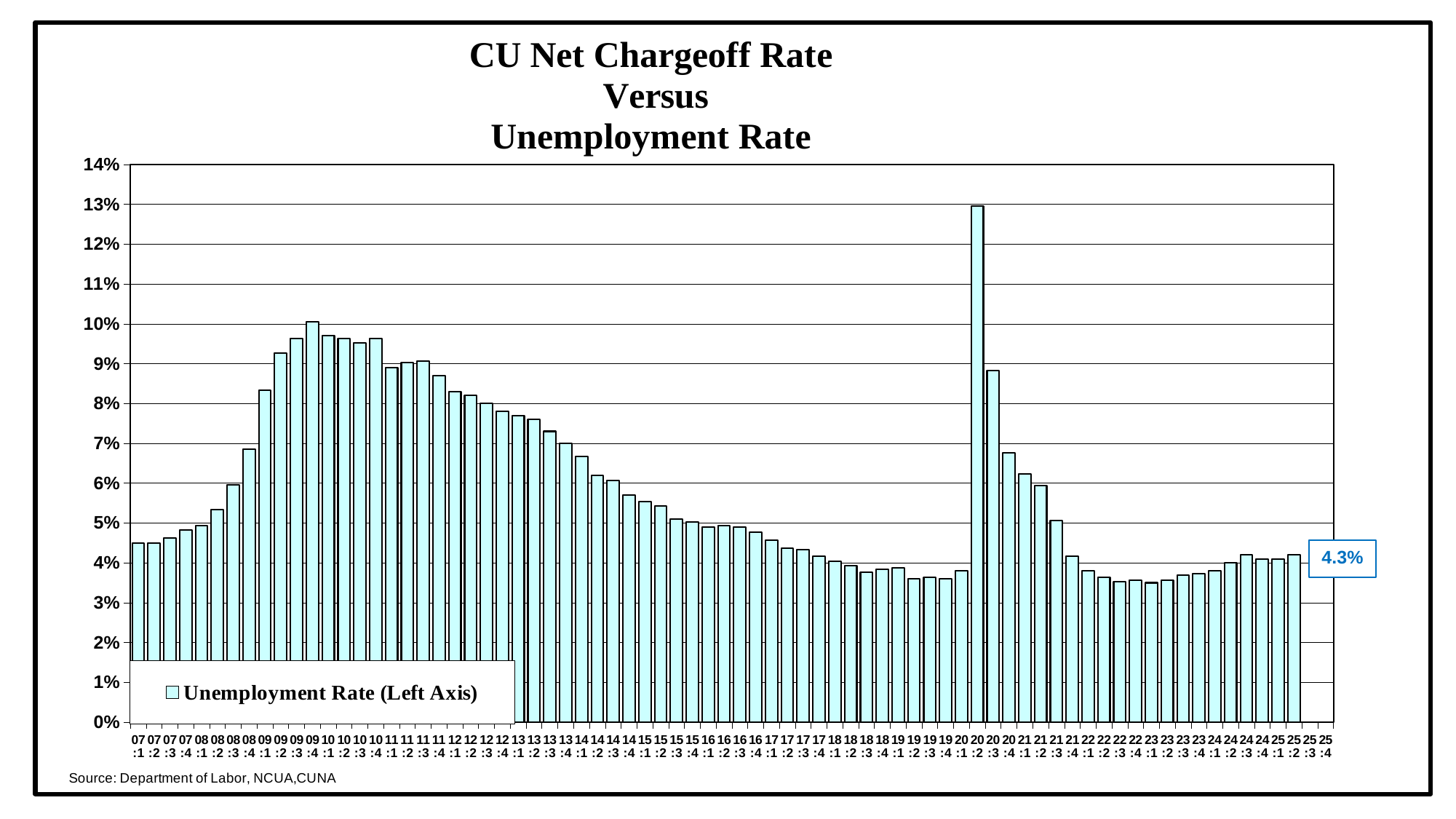
Which quarter has the higher unemployment rate, 20:2 or 09:4? 20:2 How many series does the legend list? 1 Is the unemployment rate for 13:1 greater or less than 7%? greater Do the unemployment rate values rise or fall from 09:4 to 19:4? fall Is the unemployment rate for 23:2 greater or less than 4%? less What is the title of the chart? CU Net Chargeoff Rate Versus Unemployment Rate What kind of chart is shown on the slide? bar chart Is the unemployment rate for 17:1 greater or less than 5%? less Which quarter has the highest unemployment rate? 20:2 Which quarter has the higher unemployment rate, 08:1 or 12:1? 12:1 What is the unemployment rate shown by the data label on the last bar (25:2)? 4.3%